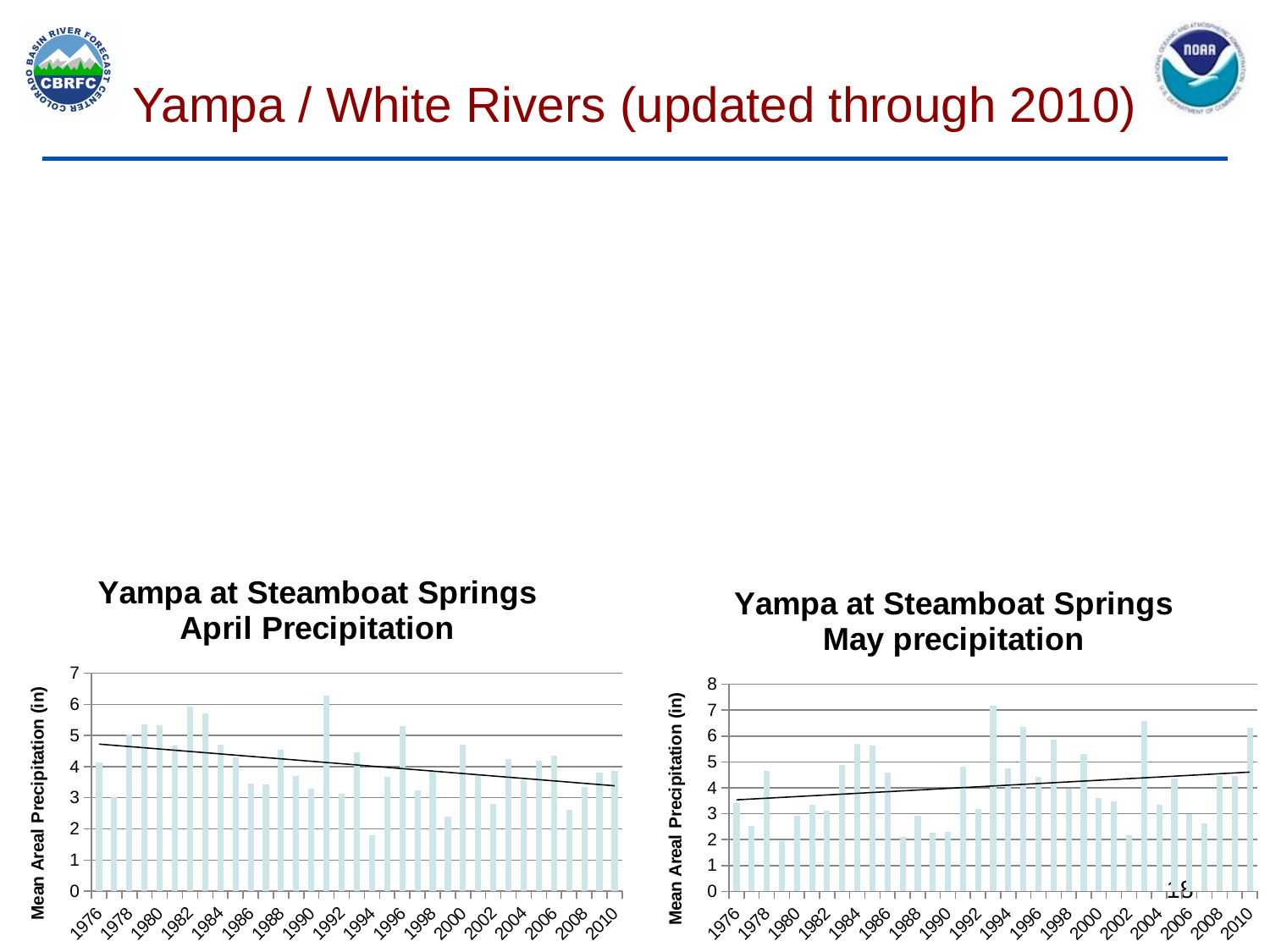
In the 'Yampa at Steamboat Springs May precipitation' chart, which year has the highest bar? 1993 In the 'Yampa at Steamboat Springs April Precipitation' chart, is the value for 1982 greater or less than 5? greater In the 'Yampa at Steamboat Springs April Precipitation' chart, is the value for 1994 greater or less than 2? less In the 'Yampa at Steamboat Springs May precipitation' chart, is the value for 1976 greater or less than 4? less What is the y-axis label on the 'Yampa at Steamboat Springs May precipitation' chart? Mean Areal Precipitation (in) In the 'Yampa at Steamboat Springs May precipitation' chart, does the trend line rise or fall from 1976 to 2010? rise In the 'Yampa at Steamboat Springs April Precipitation' chart, does the trend line rise or fall from 1976 to 2010? fall In the 'Yampa at Steamboat Springs April Precipitation' chart, which year has the highest bar? 1991 What kind of chart is the 'Yampa at Steamboat Springs April Precipitation' chart? bar chart In the 'Yampa at Steamboat Springs April Precipitation' chart, which year has the lowest bar? 1994 In the 'Yampa at Steamboat Springs April Precipitation' chart, which is larger, the value for 1991 or the value for 1999? 1991